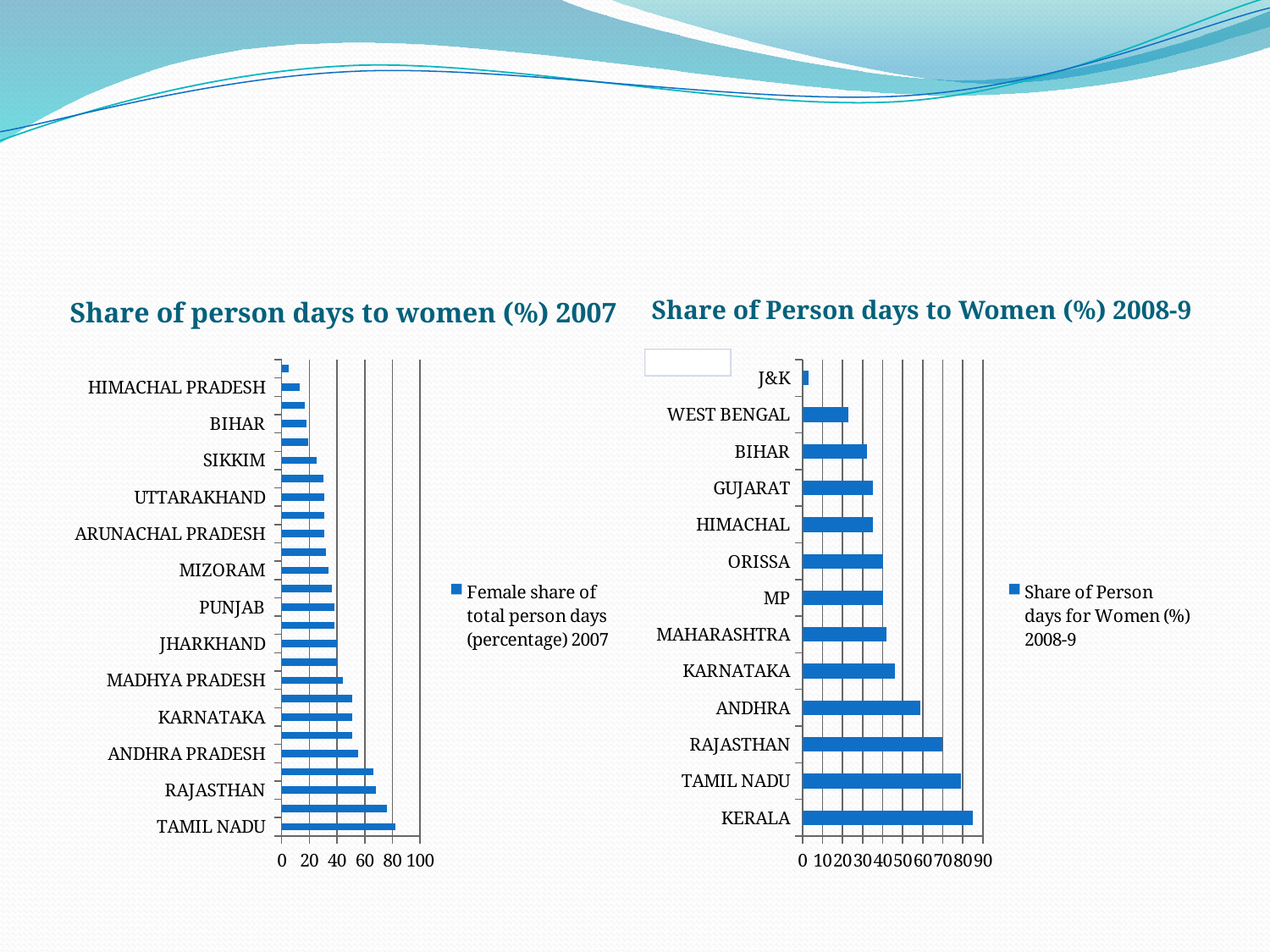
In the 'Share of Person days to Women (%) 2008-9' chart, which is larger, the value for ANDHRA or for KARNATAKA? ANDHRA What kind of chart is the 'Share of Person days to Women (%) 2008-9' chart on the right? bar chart In the 'Share of Person days to Women (%) 2008-9' chart, which state has the highest share? KERALA In the 'Share of Person days to Women (%) 2008-9' chart, which state has the lowest share? J&K In the 'Share of person days to women (%) 2007' chart on the left, which labelled state has the highest share? TAMIL NADU In the 'Share of person days to women (%) 2007' chart, which is larger, the value for RAJASTHAN or for KARNATAKA? RAJASTHAN In the 'Share of Person days to Women (%) 2008-9' chart, is the value for KERALA greater or less than 80? greater How many series does the legend of the 'Share of Person days to Women (%) 2008-9' chart list? 1 What is the legend entry of the 'Share of person days to women (%) 2007' chart? Female share of total person days (percentage) 2007 In the 'Share of Person days to Women (%) 2008-9' chart, how many states are plotted? 13 In the 'Share of person days to women (%) 2007' chart, is the value for HIMACHAL PRADESH greater or less than 20? less In the 'Share of Person days to Women (%) 2008-9' chart, is the value for WEST BENGAL greater or less than 30? less